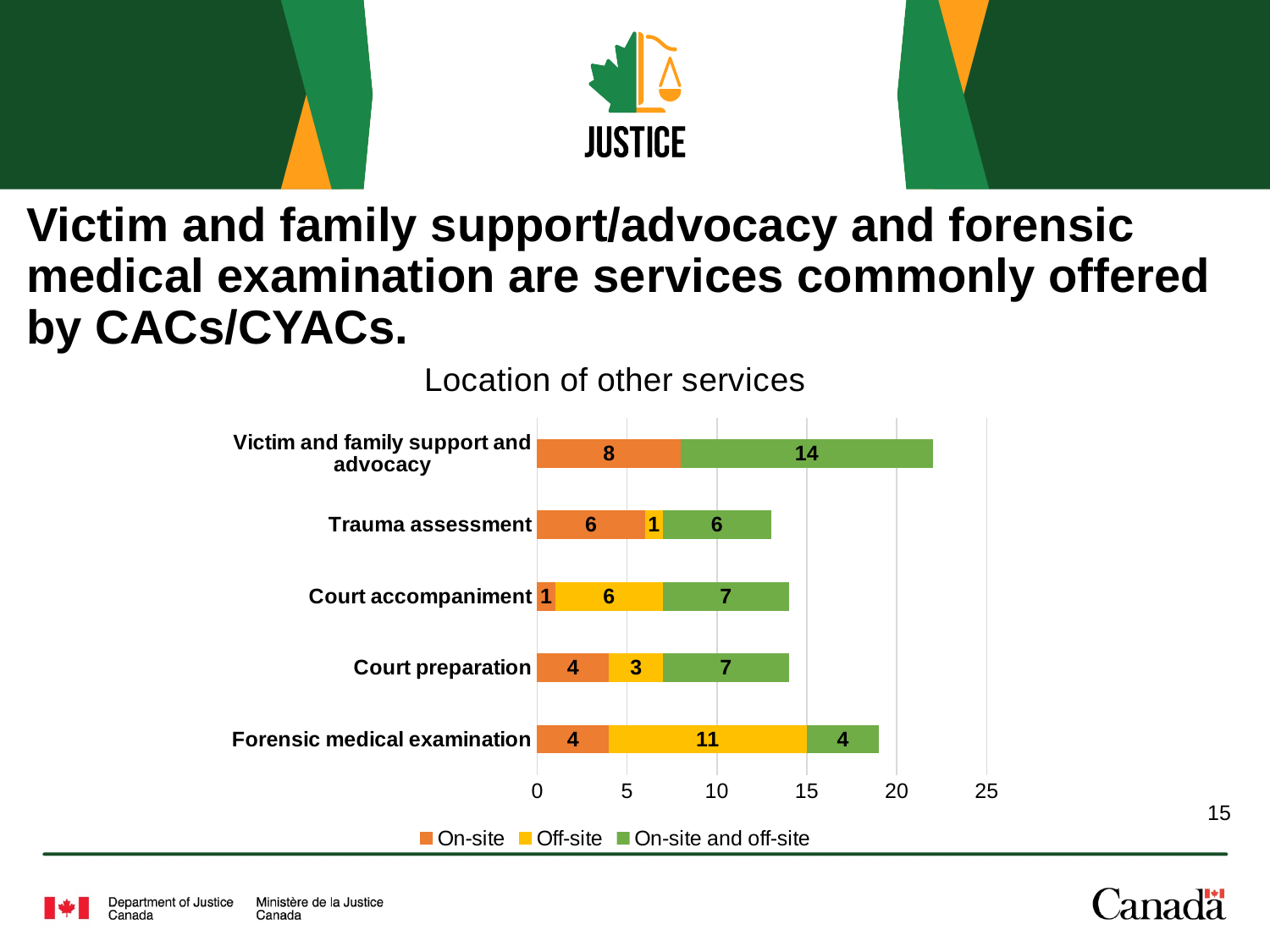
What is the On-site value for Victim and family support and advocacy? 8 What is the Off-site value for Forensic medical examination? 11 Which has the larger Off-site value, Court accompaniment or Court preparation? Court accompaniment What is the Off-site value for Trauma assessment? 1 Which category has the lowest On-site value? Court accompaniment Which category has the highest On-site and off-site value? Victim and family support and advocacy What is the total of the stacked bar for Forensic medical examination? 19 How many series does the legend list? 3 What is the difference between the On-site and off-site values for Victim and family support and advocacy and Trauma assessment? 8 How many categories are shown on the chart? 5 Which category has the highest Off-site value? Forensic medical examination What is the On-site and off-site value for Court preparation? 7